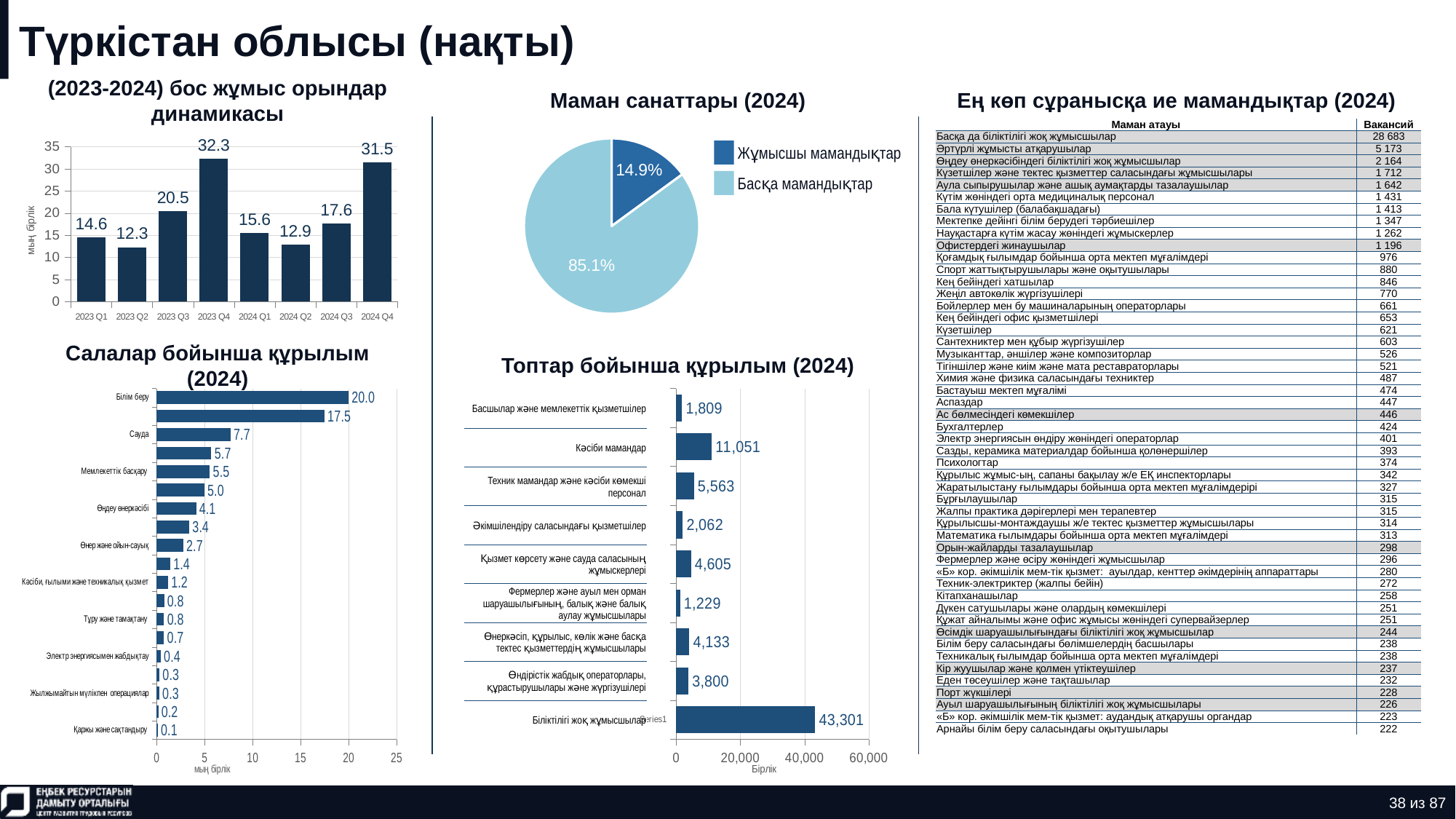
In the chart '(2023-2024) бос жұмыс орындар динамикасы', what is the value for 2023 Q4? 32.3 What kind of chart is 'Маман санаттары (2024)'? pie chart In the pie chart 'Маман санаттары (2024)', how many entries does the legend list? 2 In the chart 'Салалар бойынша құрылым (2024)', what is the value for 'Білім беру'? 20.0 In the chart 'Топтар бойынша құрылым (2024)', what is the difference between 'Кәсіби мамандар' and 'Техник мамандар және кәсіби көмекші персонал'? 5,488 In the chart '(2023-2024) бос жұмыс орындар динамикасы', which quarter has the lowest value? 2023 Q2 In the pie chart 'Маман санаттары (2024)', what share does 'Жұмысшы мамандықтар' have? 14.9% In the chart 'Топтар бойынша құрылым (2024)', what is the value for 'Кәсіби мамандар'? 11,051 In the chart '(2023-2024) бос жұмыс орындар динамикасы', what is the difference between 2023 Q4 and 2024 Q4? 0.8 In the chart '(2023-2024) бос жұмыс орындар динамикасы', how many quarters are plotted? 8 In the chart '(2023-2024) бос жұмыс орындар динамикасы', which is larger, 2024 Q1 or 2024 Q3? 2024 Q3 In the chart 'Топтар бойынша құрылым (2024)', which category has the highest value? Біліктілігі жоқ жұмысшылар